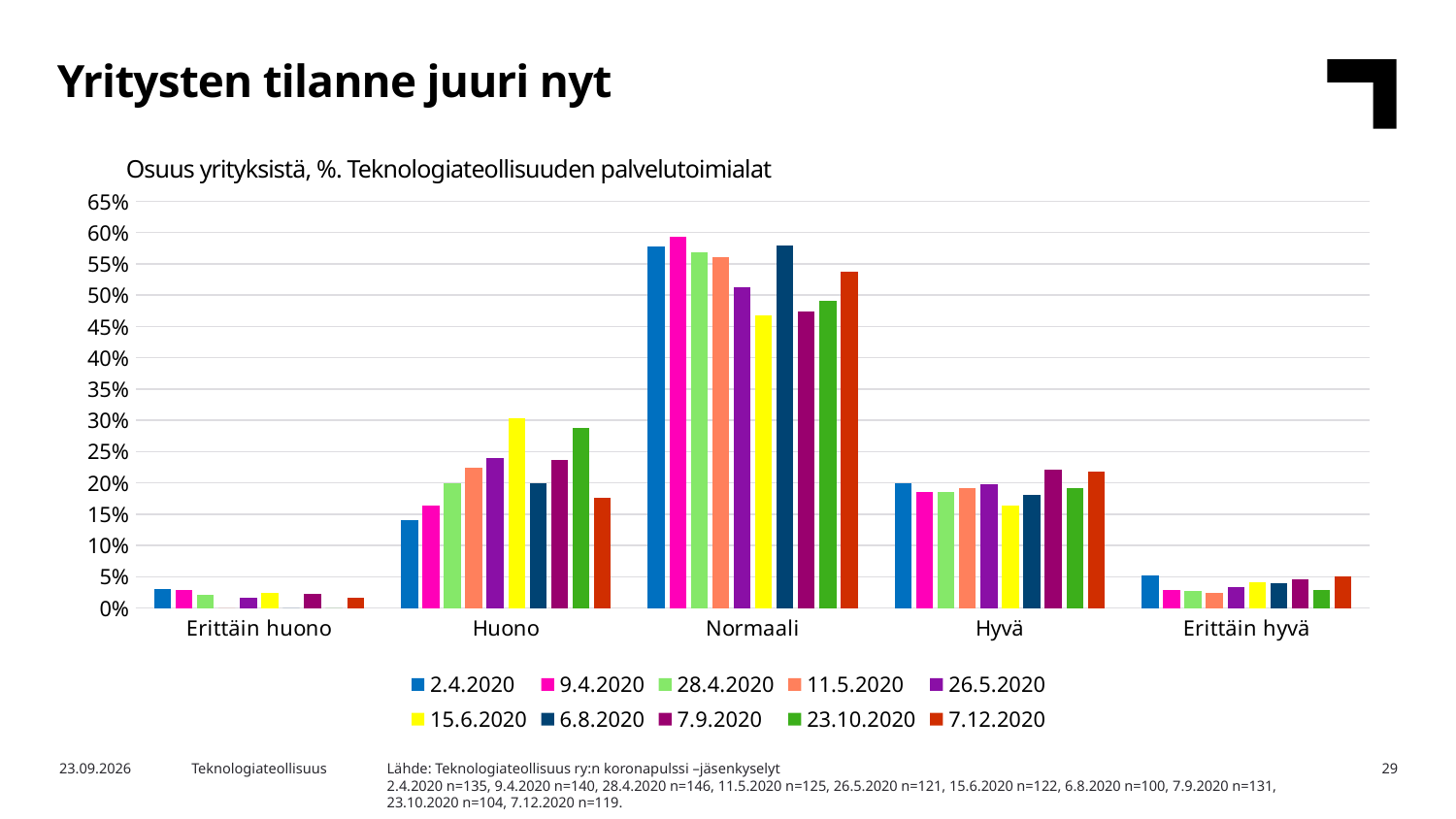
Is the value for Erittäin huono in the 2.4.2020 series greater or less than 5%? less Which category has the tallest bars in the chart? Normaali Is the value for Huono in the 15.6.2020 series greater or less than 25%? greater How many categories are shown on the x axis of the chart? 5 In the Normaali category, which is larger: the value for 9.4.2020 or the value for 7.9.2020? 9.4.2020 How many series does the chart's legend list? 10 What kind of chart is shown on the slide? bar chart For the 9.4.2020 series, which category has the highest value? Normaali What is the title of the slide containing the chart? Yritysten tilanne juuri nyt Is the value for Normaali in the 15.6.2020 series greater or less than 50%? less In the Huono category, which is larger: the value for 15.6.2020 or the value for 2.4.2020? 15.6.2020